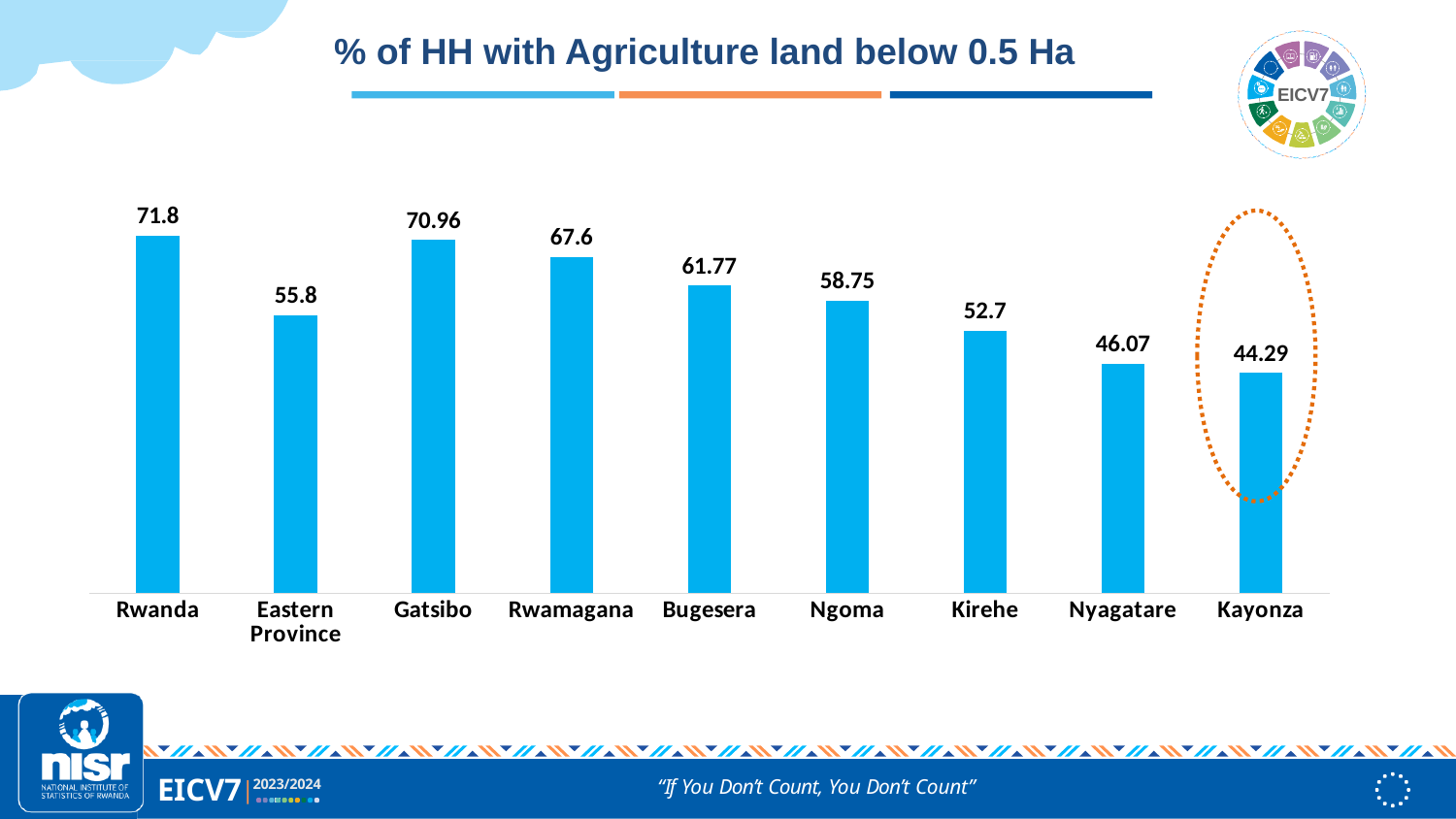
Which is larger, the value for Ngoma or the value for Kirehe? Ngoma How many categories are shown on the chart? 9 Which bar is highlighted with a dashed orange oval? Kayonza What is the value for Eastern Province? 55.8 What is the value for Rwanda? 71.8 What is the value for Bugesera? 61.77 What is the title of the chart? % of HH with Agriculture land below 0.5 Ha What is the value for Kayonza? 44.29 What is the difference between the values for Gatsibo and Kayonza? 26.67 What kind of chart is shown on the slide? bar chart Which category has the highest value? Rwanda Which category has the lowest value? Kayonza